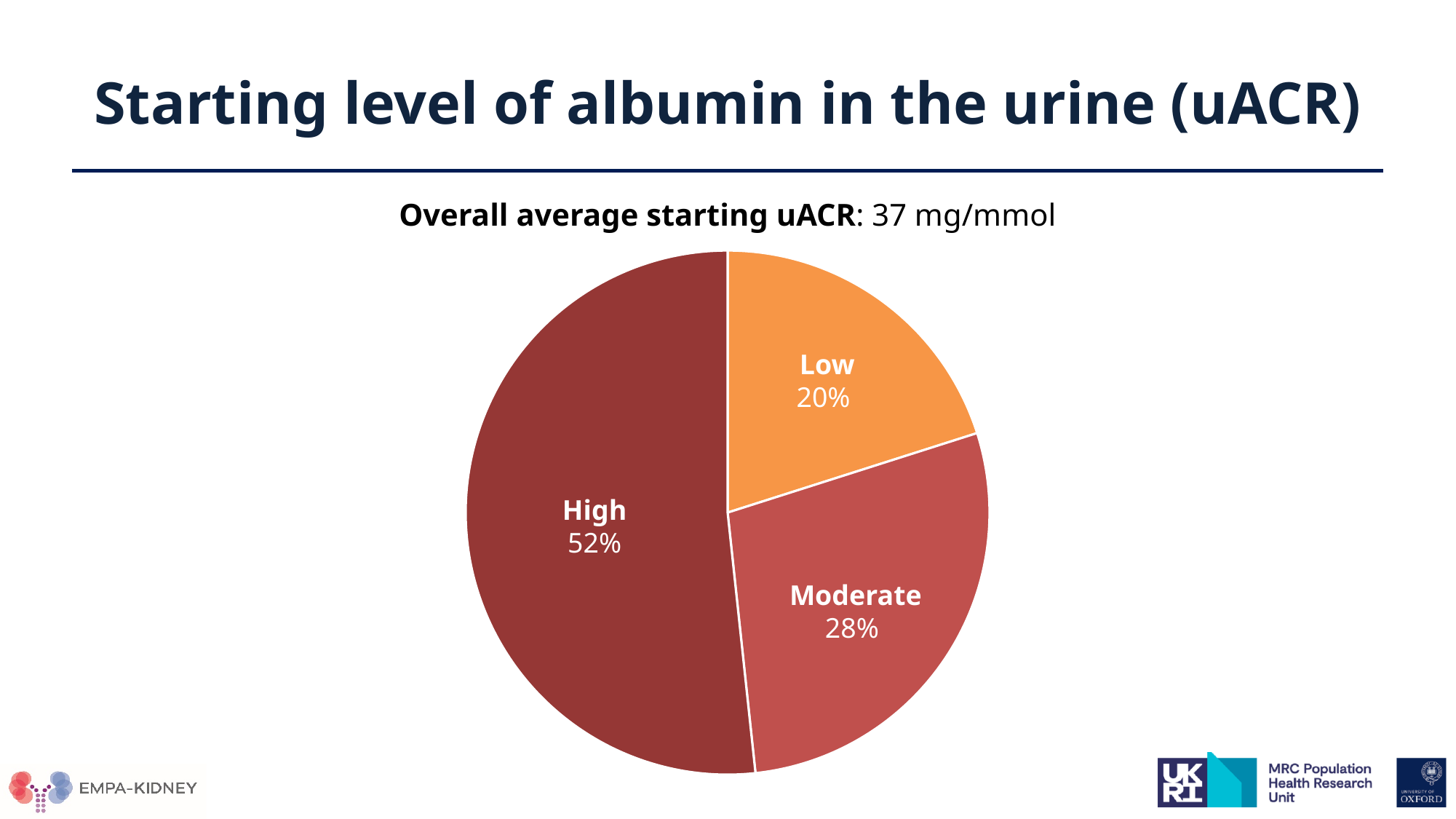
Which category has the smallest slice of the pie? Low What is the title of the slide? Starting level of albumin in the urine (uACR) What is the overall average starting uACR stated above the chart? 37 mg/mmol What share of the pie is the Low category? 20% What is the difference in percentage points between the Moderate and Low slices? 8 What kind of chart is shown on the slide? Pie chart Which category has the largest slice of the pie? High What share of the pie is the High category? 52% What share of the pie is the Moderate category? 28% How many categories are shown in the pie chart? 3 What is the difference in percentage points between the High and Moderate slices? 24 Which slice is larger, Moderate or Low? Moderate